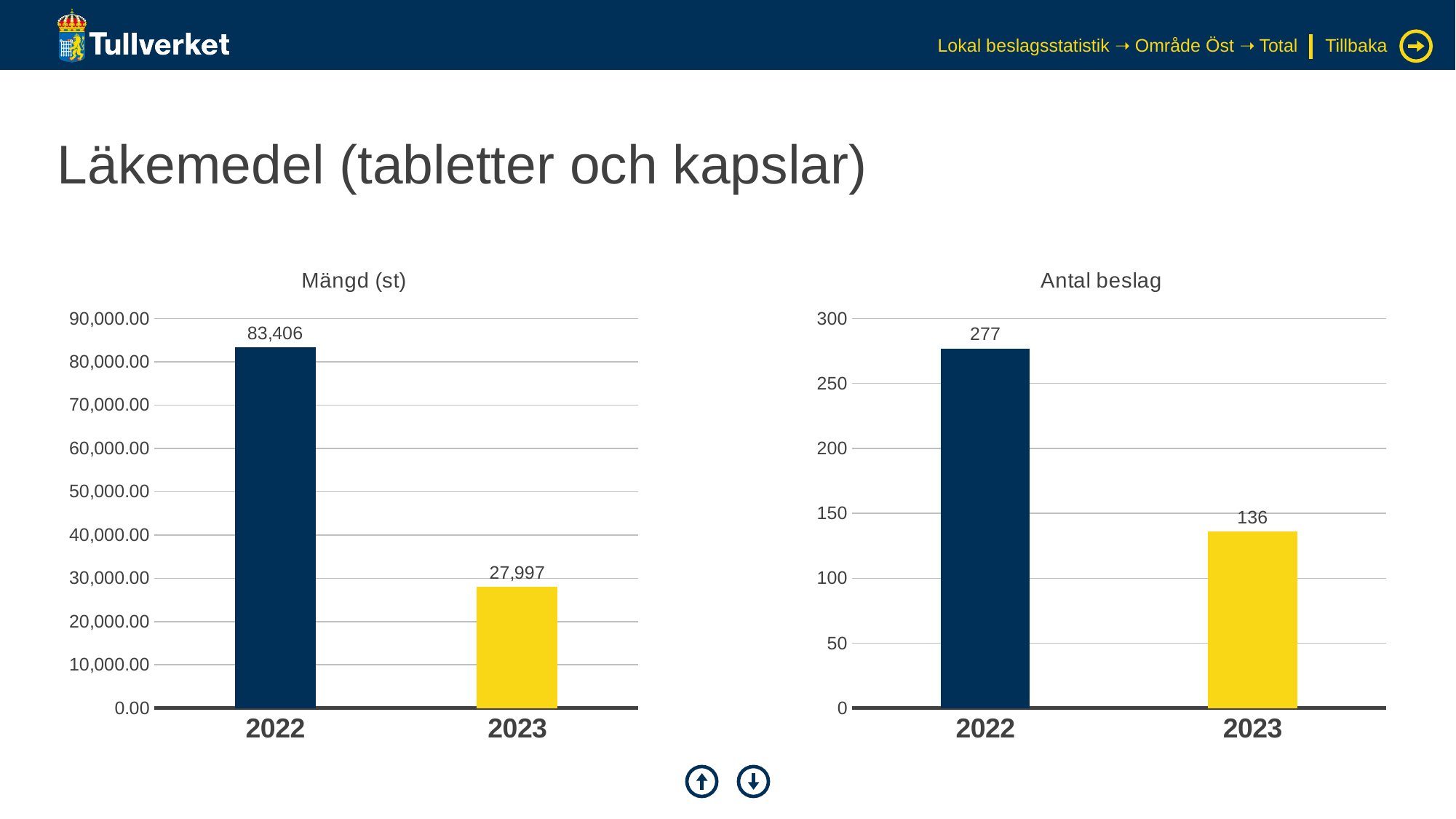
In the "Antal beslag" chart, which year has the lowest value? 2023 In the "Antal beslag" chart, is the value for 2022 greater or less than 250? greater In the "Mängd (st)" chart, what is the value for 2023? 27,997 In the "Antal beslag" chart, what is the value for 2023? 136 In the "Mängd (st)" chart, which year has the highest value? 2022 In the "Mängd (st)" chart, do the values rise or fall from 2022 to 2023? fall How many categories are shown on the x axis of the "Mängd (st)" chart? 2 In the "Antal beslag" chart, what is the difference between the 2022 and 2023 values? 141 In the "Mängd (st)" chart, what is the difference between the 2022 and 2023 values? 55,409 What kind of chart is the "Antal beslag" chart? bar chart In the "Antal beslag" chart, what is the value for 2022? 277 In the "Mängd (st)" chart, what is the value for 2022? 83,406